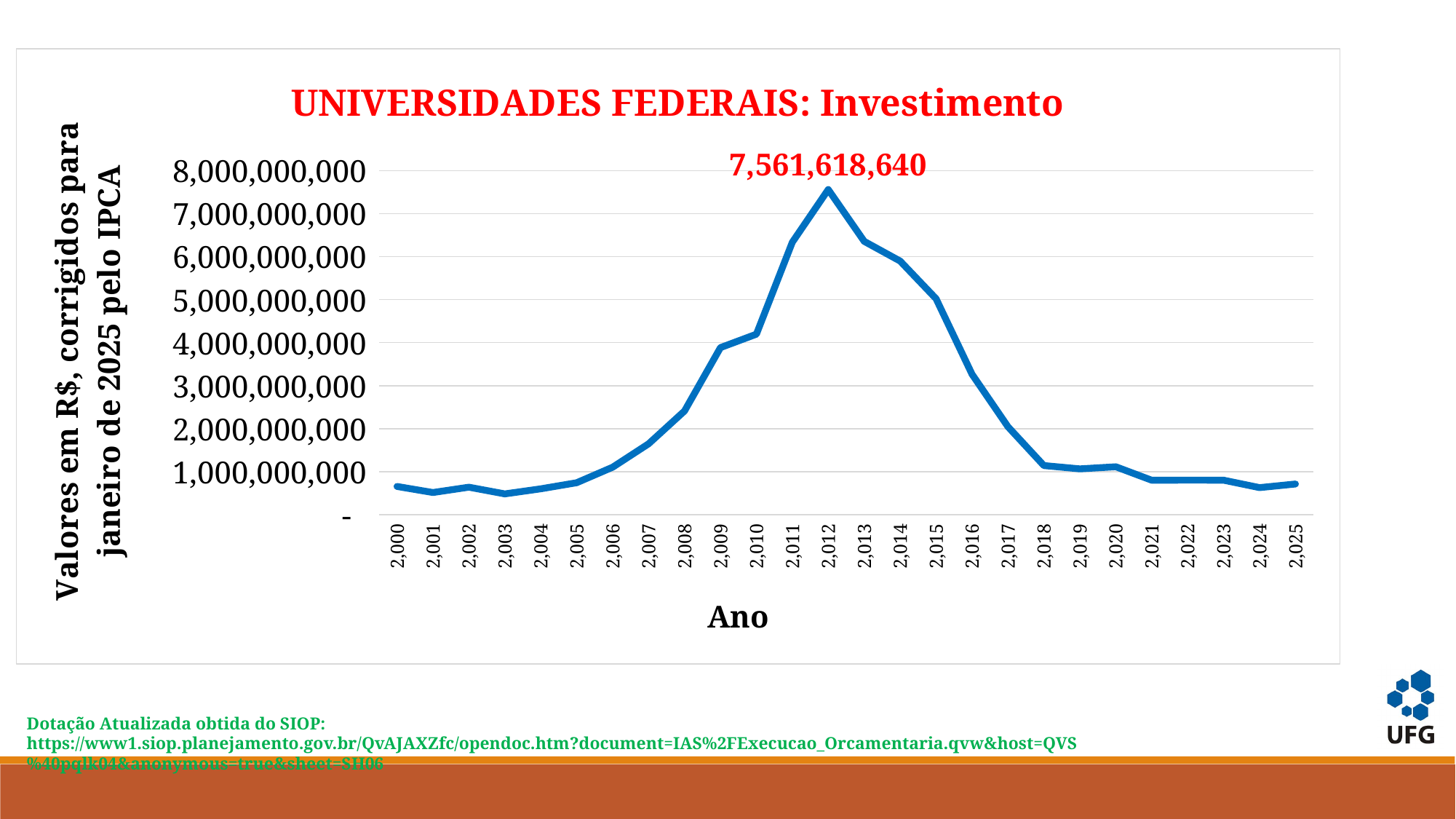
Which year has the larger value, 2008 or 2016? 2016 What value is labelled on the peak of the line in the chart? 7,561,618,640 What is the title of the chart? UNIVERSIDADES FEDERAIS: Investimento Is the value for 2016 greater or less than 3,000,000,000? greater In which year does the investment reach its highest value? 2012 Is the value for 2013 greater or less than 6,000,000,000? greater Do the values rise or fall between 2012 and 2018? fall How many years (data points) are plotted along the x axis? 26 Is the value for 2000 greater or less than 1,000,000,000? less What type of chart is shown on the slide? line chart What is the label of the x axis? Ano